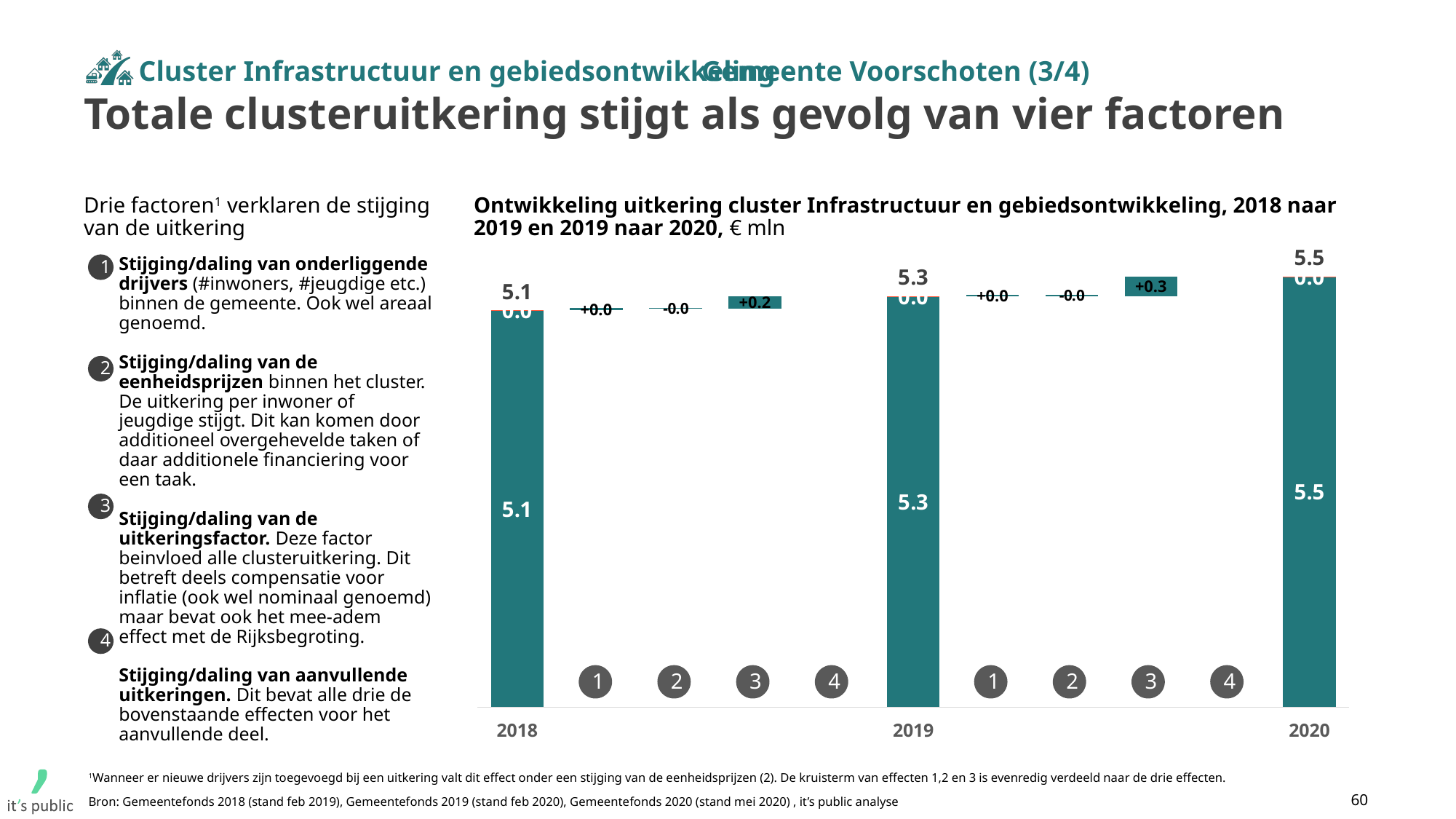
What is the value of factor 3 (uitkeringsfactor) in the step from 2019 to 2020? +0.3 How many year totals are shown on the chart? 3 What is the total uitkering for 2018 shown on the chart? 5.1 What is the value of factor 3 (uitkeringsfactor) in the step from 2018 to 2019? +0.2 Which is larger, the total uitkering in 2019 or in 2018? 2019 What is the total uitkering for 2020 shown on the chart? 5.5 What is the difference between the total uitkering in 2020 and in 2018? 0.4 Do the total uitkering values rise or fall from 2018 to 2020? rise Is the effect of factor 3 larger in the step 2018 to 2019 or in the step 2019 to 2020? 2019 to 2020 In what unit are the values on the chart expressed? € mln Which year has the highest total uitkering? 2020 Which year has the lowest total uitkering? 2018